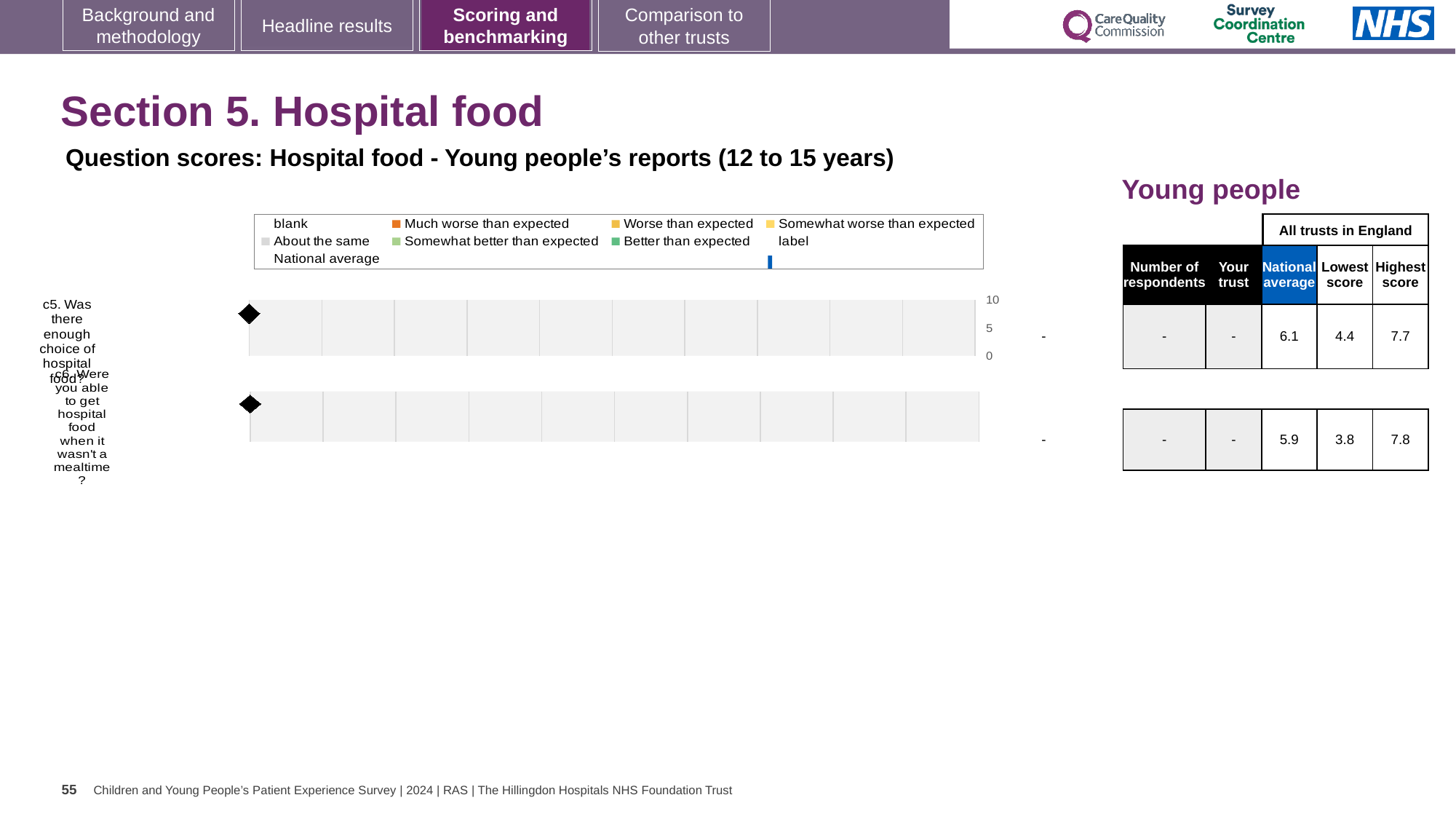
In the table beside the chart, what is the national average score for c5 (Was there enough choice of hospital food?)? 6.1 What is the first legend entry listed in the chart legend? blank In the table beside the chart, what is the lowest score for c5 (Was there enough choice of hospital food?)? 4.4 In the table beside the chart, which question has the higher national average, c5 or c6? c5 In the table beside the chart, what is the highest score for c6 (Were you able to get hospital food when it wasn't a mealtime?)? 7.8 In the table beside the chart, what is the difference between the highest and lowest scores for c6? 4.0 In the table beside the chart, what is the national average score for c6 (Were you able to get hospital food when it wasn't a mealtime?)? 5.9 How many survey questions are plotted in the chart area (c5 and c6)? 2 In the table beside the chart, what is the highest score for c5 (Was there enough choice of hospital food?)? 7.7 In the table beside the chart, what is the lowest score for c6 (Were you able to get hospital food when it wasn't a mealtime?)? 3.8 In the table beside the chart, what is the difference between the highest and lowest scores for c5? 3.3 What is the highest value shown on the chart's numeric axis? 10